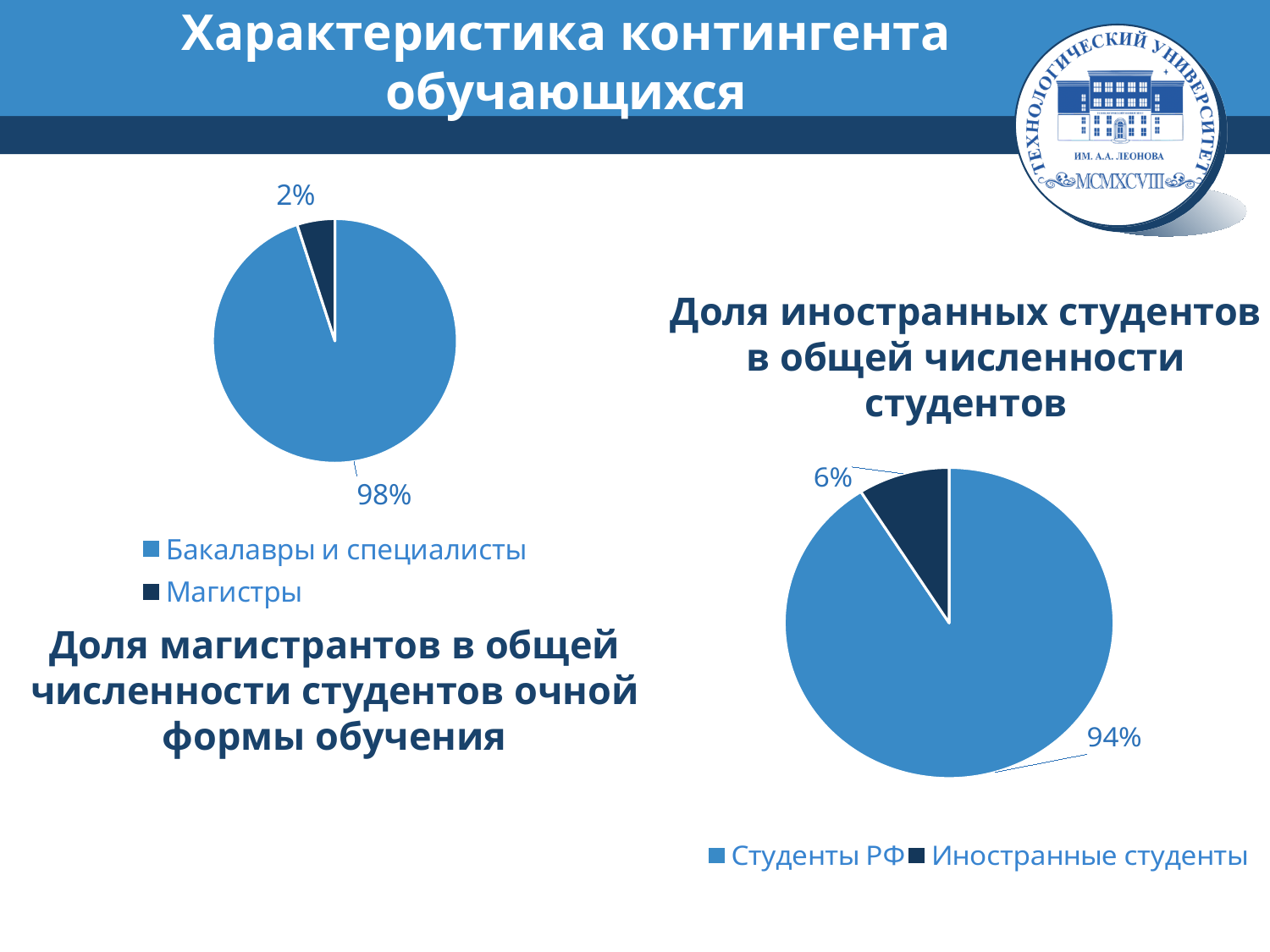
How many entries does the legend of the left pie chart list? 2 In the left pie chart, which category has the largest slice? Бакалавры и специалисты In the right pie chart, what is the difference between the shares of Студенты РФ and Иностранные студенты? 88% What type of chart is used on the left side of the slide? Pie chart In the left pie chart (Доля магистрантов в общей численности студентов очной формы обучения), what share is labelled for Магистры? 2% In the left pie chart, what share is labelled for Бакалавры и специалисты? 98% How many slices does the right pie chart have? 2 In the right pie chart, what share is labelled for Студенты РФ? 94% Which is larger: the share of Магистры in the left pie chart or the share of Иностранные студенты in the right pie chart? Иностранные студенты In the right pie chart, which category has the smallest slice? Иностранные студенты In the right pie chart (Доля иностранных студентов в общей численности студентов), what share is labelled for Иностранные студенты? 6% In the left pie chart, what is the difference between the shares of Бакалавры и специалисты and Магистры? 96%